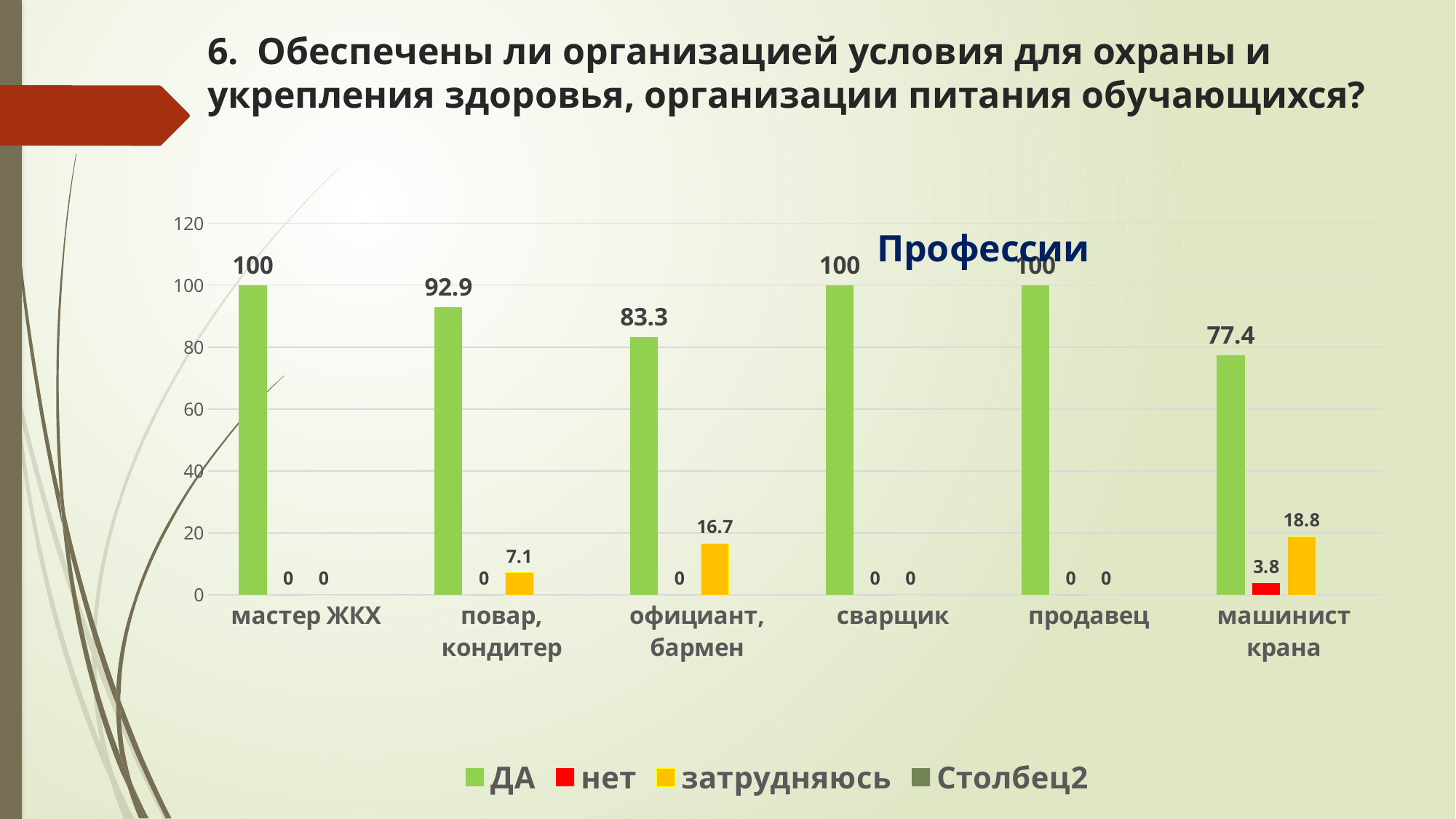
What is the value of the затрудняюсь series for официант, бармен? 16.7 What is the difference between the ДА values for мастер ЖКХ and машинист крана? 22.6 How many series does the legend list? 4 What is the value of the ДА series for повар, кондитер? 92.9 Is the ДА value for официант, бармен greater or less than 80? greater Which category has the highest value in the затрудняюсь series? машинист крана Which category has the lowest value in the ДА series? машинист крана How many categories are shown on the x axis? 6 Which is larger: the затрудняюсь value for повар, кондитер or for официант, бармен? официант, бармен What is the value of the нет series for машинист крана? 3.8 What is the title of the chart? Профессии What kind of chart is shown on the slide? bar chart